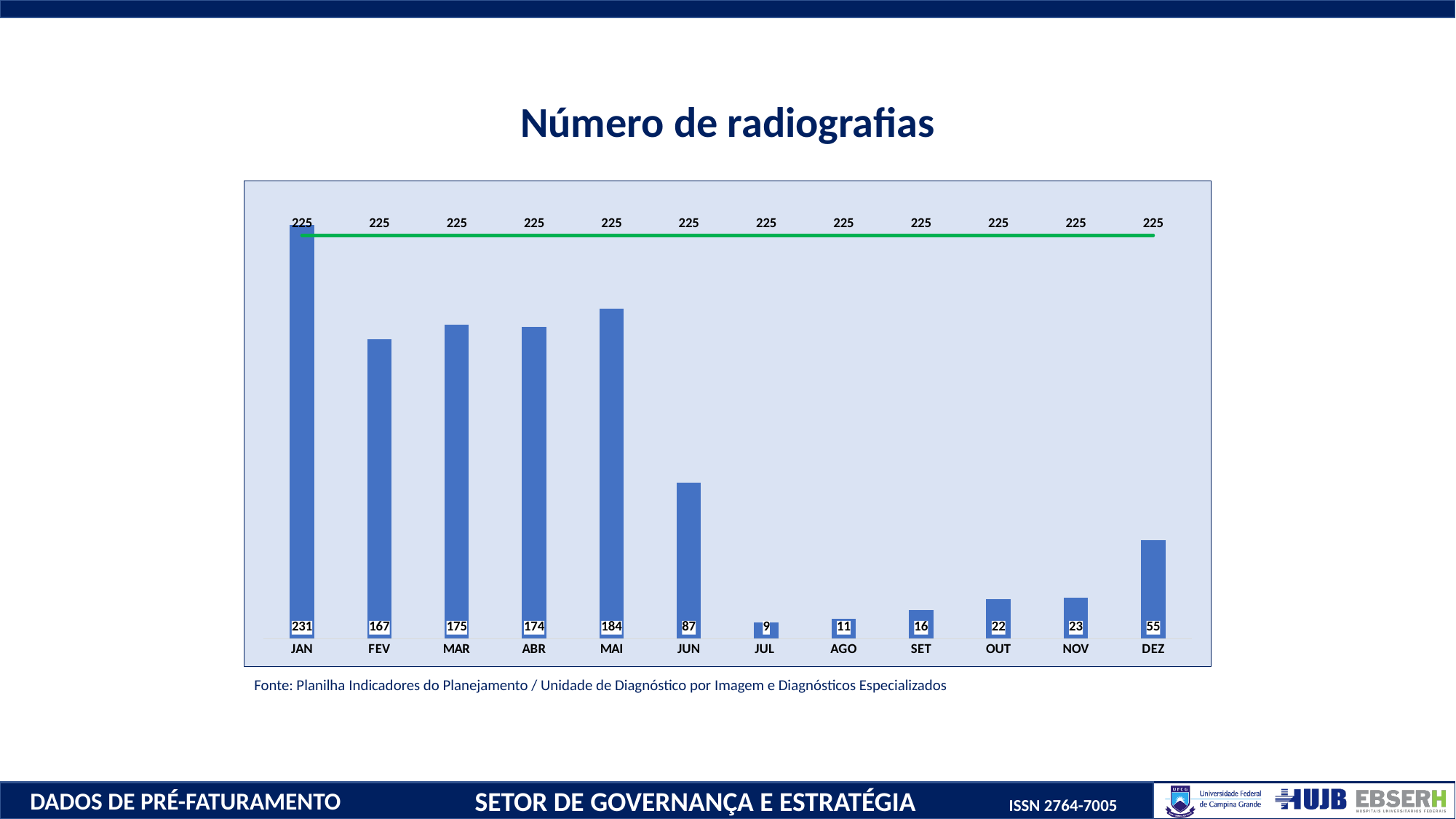
Which month has the highest bar value? JAN What is the title of the chart? Número de radiografias What is the value of the green line for each month? 225 Which is larger, the bar value for MAR or the bar value for ABR? MAR What is the value of the bar for DEZ? 55 How many months are shown on the x axis? 12 What is the value of the bar for JAN? 231 What is the value of the bar for JUL? 9 What is the difference between the bar values for JAN and FEV? 64 What is the value of the bar for MAI? 184 What kind of chart is shown on the slide? Bar chart with a line Which month has the lowest bar value? JUL